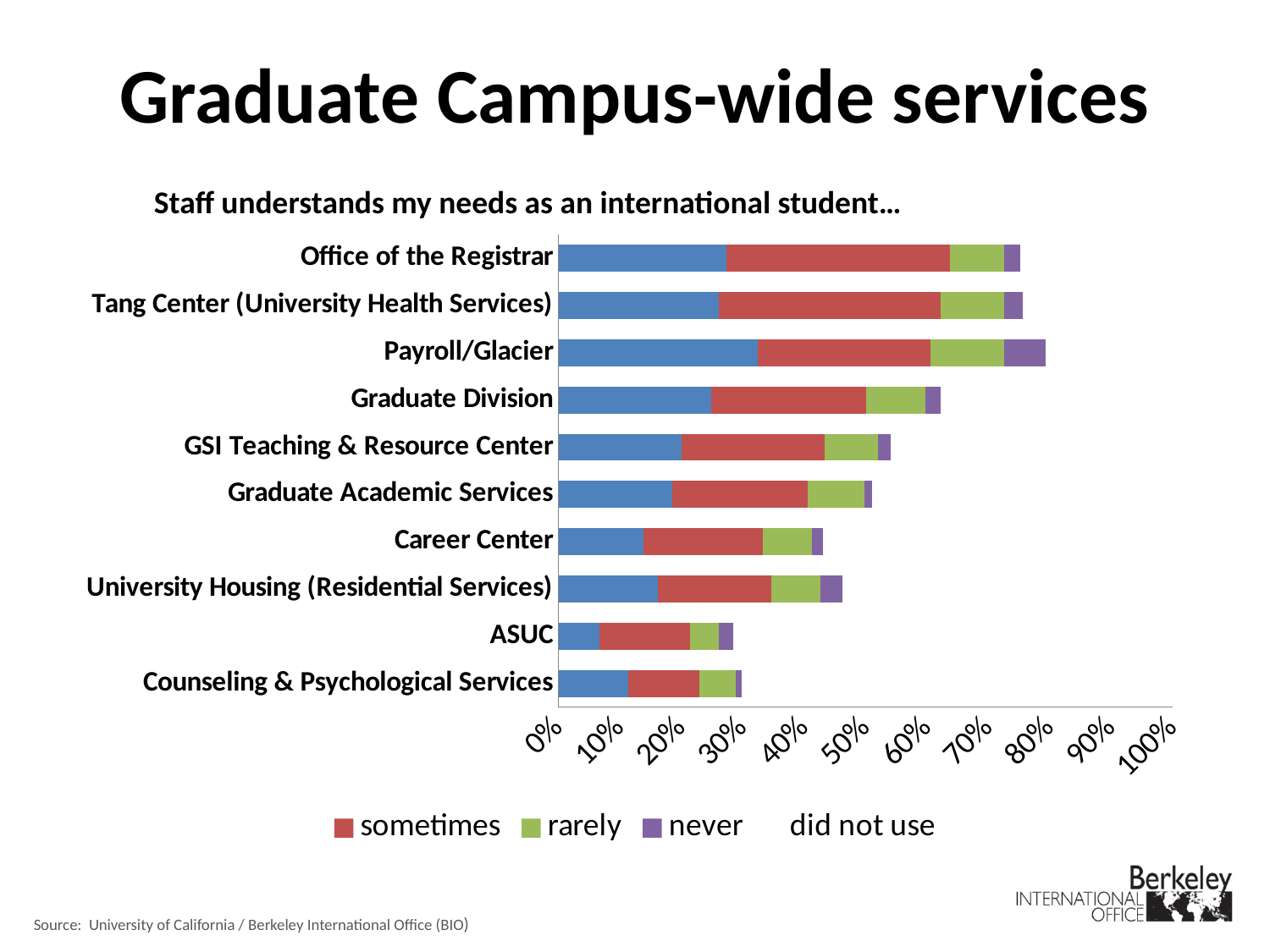
What kind of chart is shown on the slide? Stacked bar chart Is the total bar for Career Center greater or less than 50%? less Is the total bar for Office of the Registrar greater or less than 70%? greater Which has the longer total bar, ASUC or Office of the Registrar? Office of the Registrar Which has the longer total bar, Graduate Division or GSI Teaching & Resource Center? Graduate Division How many entries does the chart legend list? 4 Which service has the longest total bar on the chart? Payroll/Glacier What is the subtitle (statement) shown above the chart? Staff understands my needs as an international student… What colour represents the "sometimes" series in the chart? Red Is the total bar for Graduate Division greater or less than 50%? greater How many campus services (categories) are plotted on the chart? 10